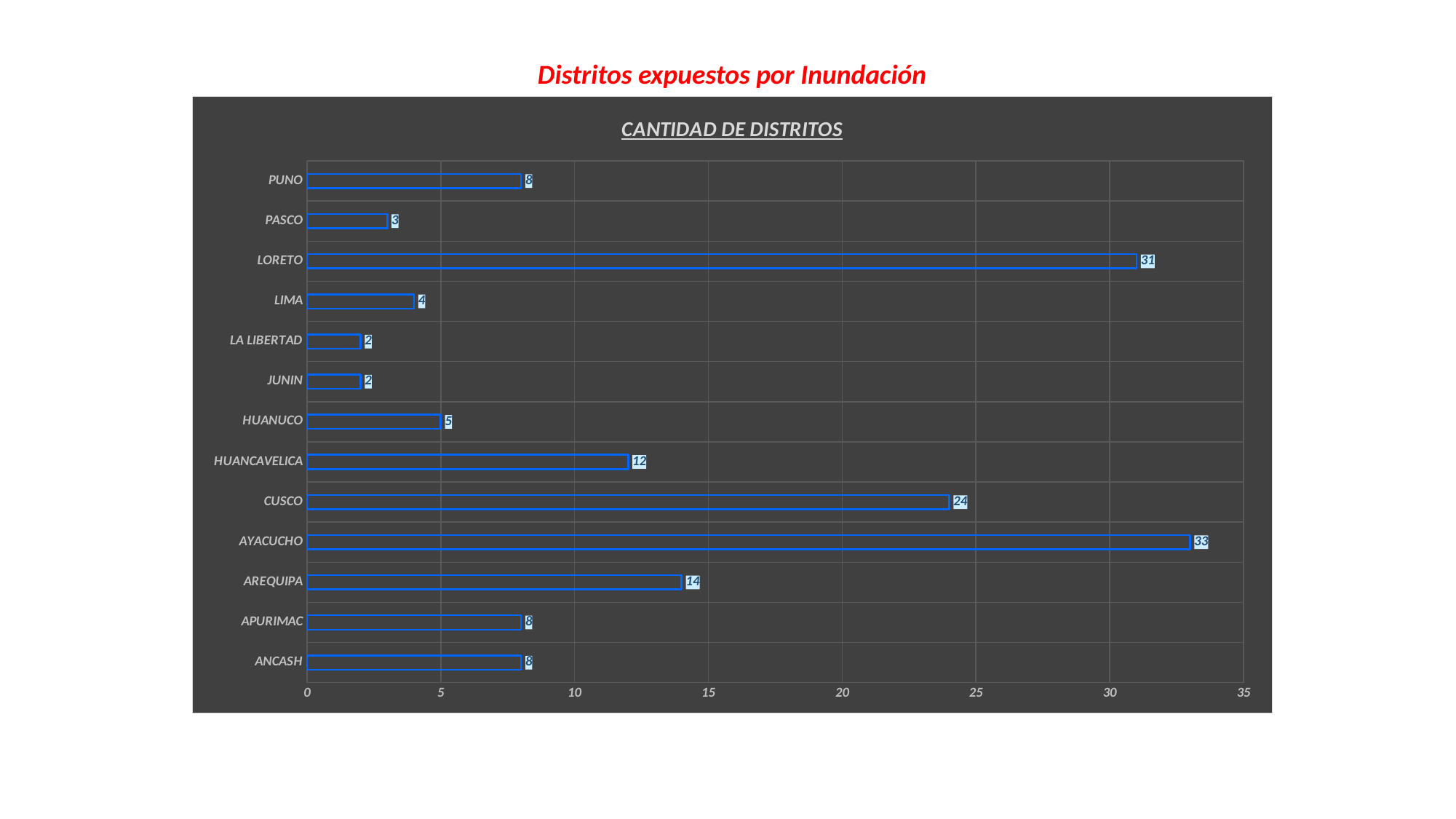
What is the value for HUANCAVELICA? 12 Which category has the highest value? AYACUCHO Is the value for CUSCO greater or less than 20? greater How many categories are shown on the chart? 13 What is the difference between the values for HUANUCO and LIMA? 1 What is the value for PASCO? 3 What kind of chart is shown on the slide? bar chart What is the value for LORETO? 31 What is the title of the chart? CANTIDAD DE DISTRITOS Which is larger, the value for LORETO or the value for CUSCO? LORETO What is the difference between the values for AYACUCHO and CUSCO? 9 What is the value for AREQUIPA? 14